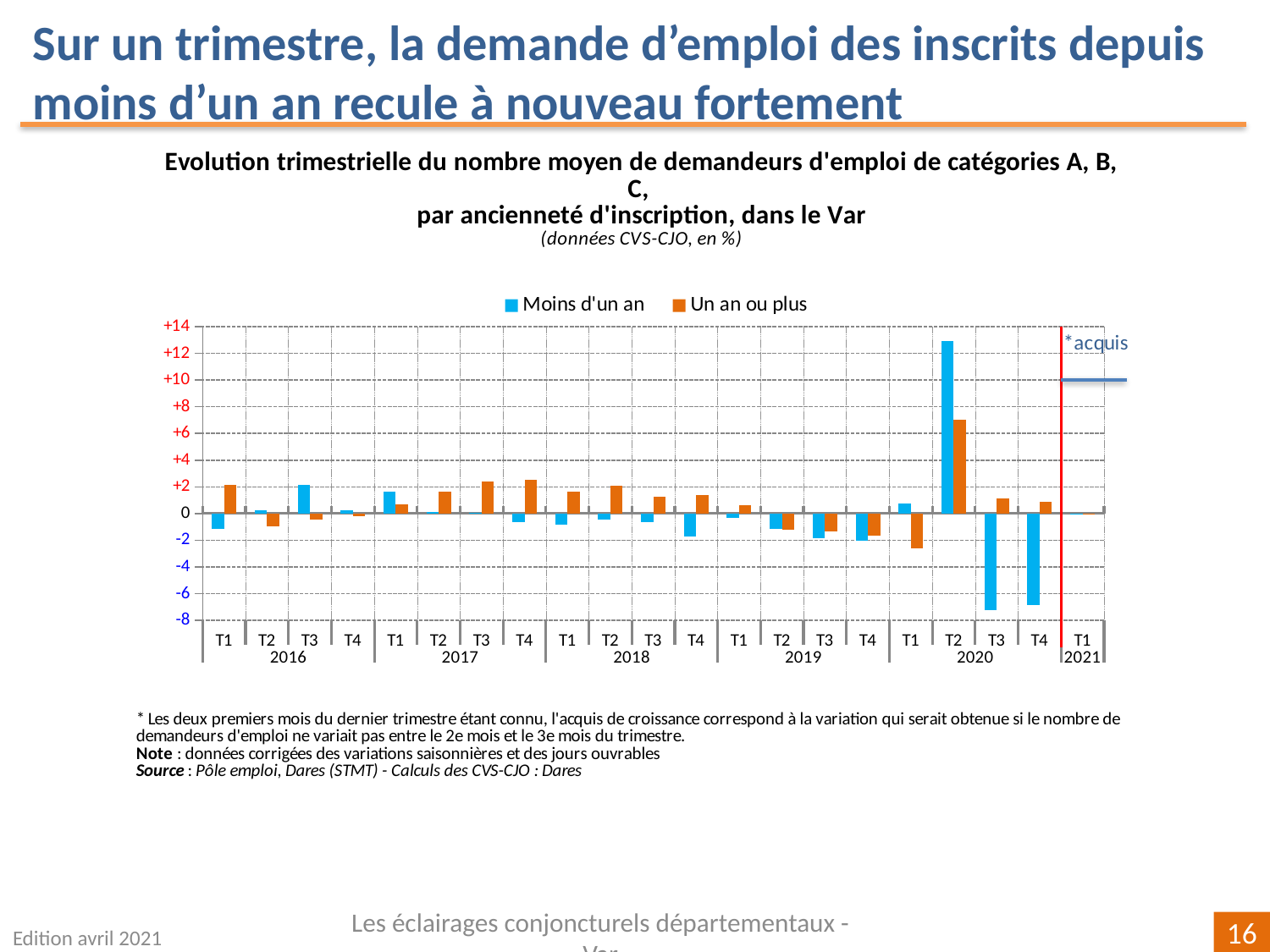
How many quarters are plotted along the x axis? 21 Is the value for 'Un an ou plus' in T2 2020 greater or less than +6? greater What are the two series named in the legend? Moins d'un an; Un an ou plus In which quarter is the value for 'Un an ou plus' highest? T2 2020 How many series does the legend list? 2 Which quarter is marked by the red vertical line labelled '*acquis'? T1 2021 Is the value for 'Moins d'un an' in T2 2020 greater or less than +10? greater In which quarter is the value for 'Moins d'un an' highest? T2 2020 In T1 2016, which series has the larger value, 'Moins d'un an' or 'Un an ou plus'? Un an ou plus In which quarter is the value for 'Un an ou plus' lowest? T1 2020 What kind of chart is shown on the slide? bar chart Is the value for 'Moins d'un an' in T3 2020 greater or less than -6? less